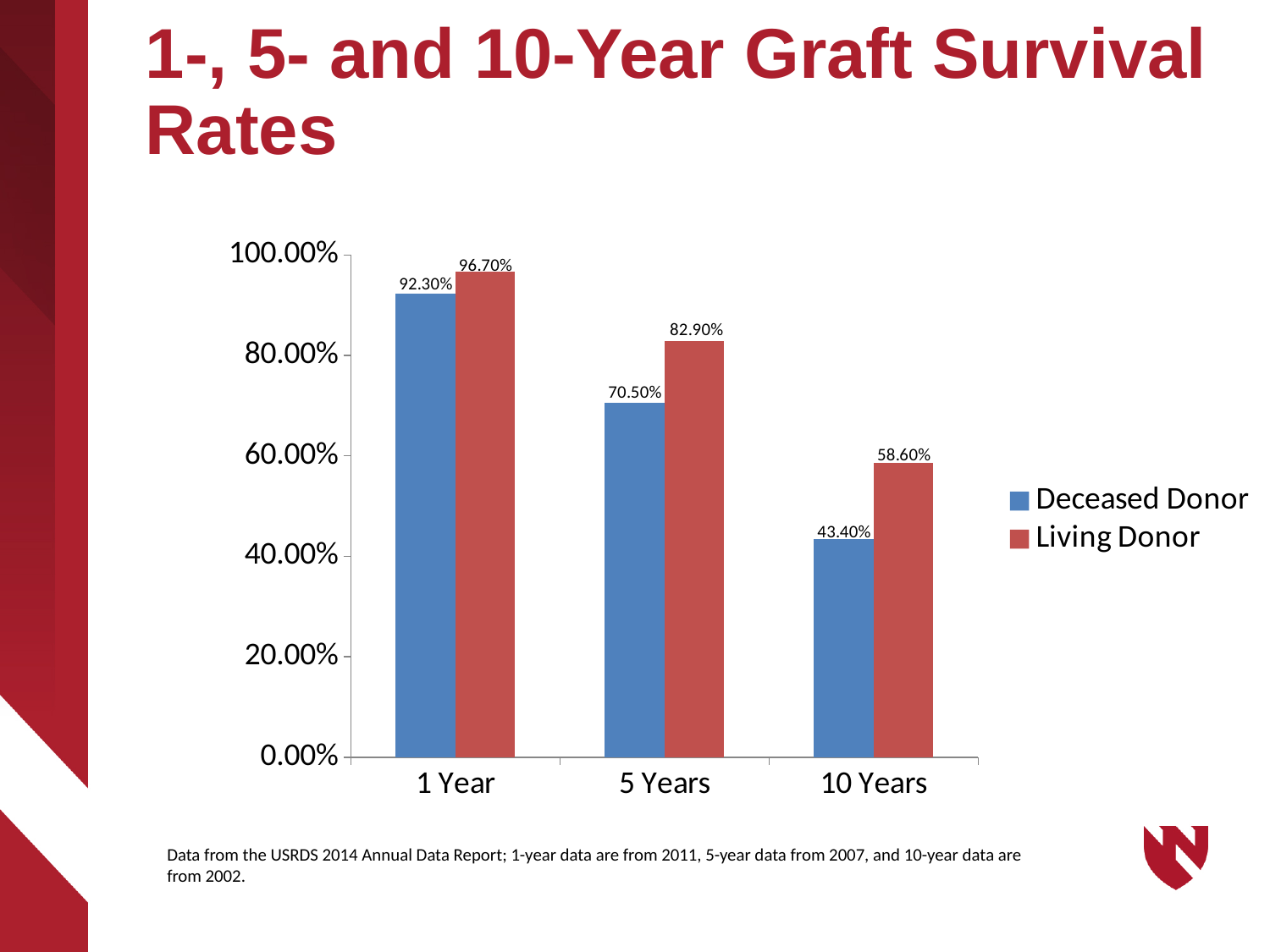
How many series does the legend list? 2 What is the graft survival rate for Deceased Donor at 1 Year? 92.30% How many time points are shown on the x axis? 3 What is the graft survival rate for Living Donor at 1 Year? 96.70% Do the Deceased Donor graft survival rates rise or fall from 1 Year to 10 Years? Fall What is the graft survival rate for Deceased Donor at 10 Years? 43.40% What is the difference between the Living Donor and Deceased Donor graft survival rates at 10 Years? 15.20% What is the graft survival rate for Living Donor at 5 Years? 82.90% Which time point has the lowest Deceased Donor graft survival rate? 10 Years At 5 Years, which is larger: the Deceased Donor or the Living Donor graft survival rate? Living Donor Which time point has the highest Living Donor graft survival rate? 1 Year What kind of chart is shown on the slide? Bar chart